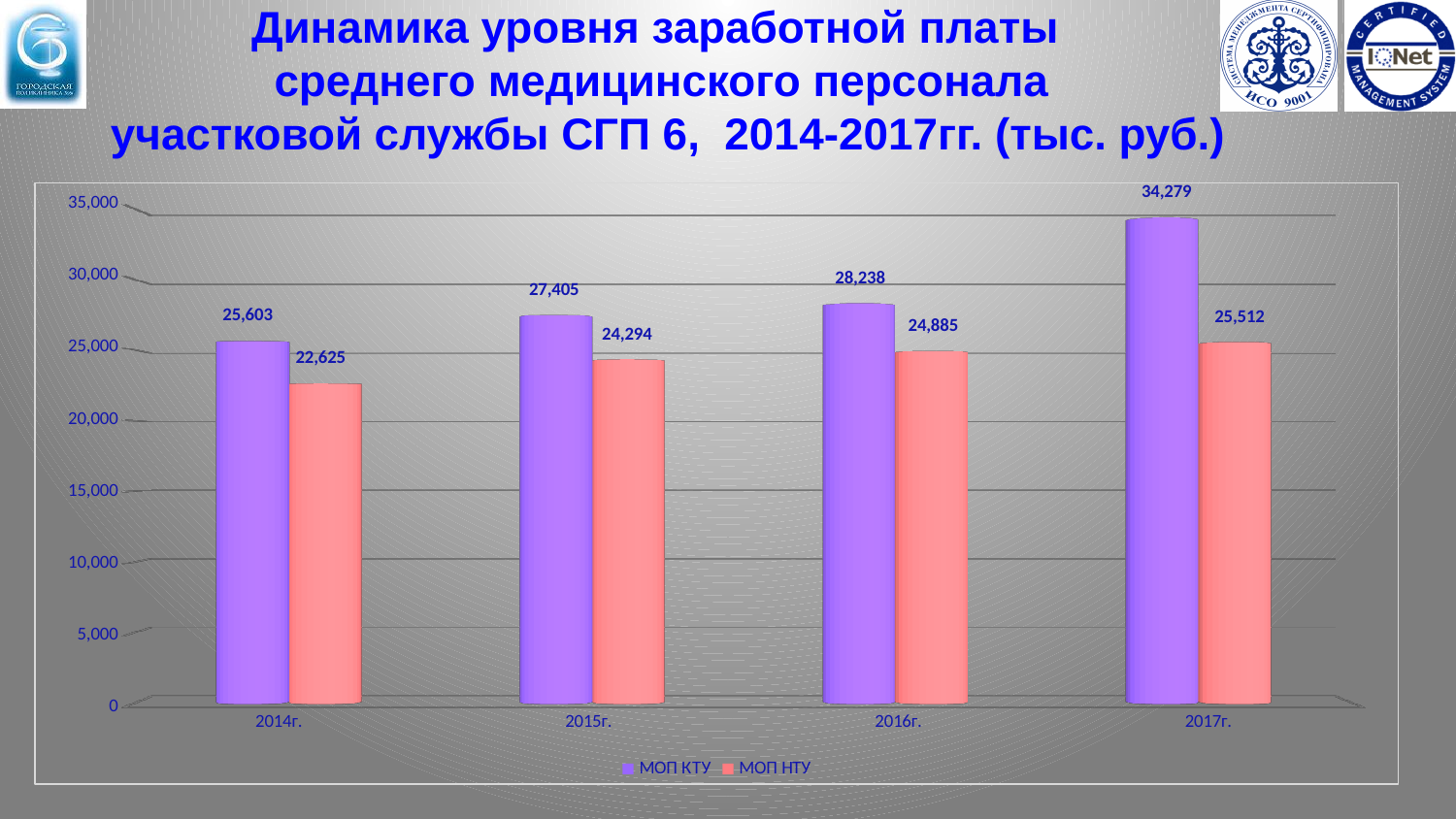
What is the value for МОП НТУ in 2016г.? 24,885 What is the difference between МОП КТУ and МОП НТУ in 2017г.? 8,767 Do the values for МОП КТУ rise or fall from 2014г. to 2017г.? rise How many years are shown on the x axis? 4 Which is larger in 2016г., МОП КТУ or МОП НТУ? МОП КТУ In which year is the value for МОП КТУ highest? 2017г. In which year is the value for МОП НТУ lowest? 2014г. How many series does the legend list? 2 What is the value for МОП КТУ in 2015г.? 27,405 What kind of chart is shown on the slide? bar chart What is the value for МОП НТУ in 2014г.? 22,625 What is the value for МОП КТУ in 2017г.? 34,279